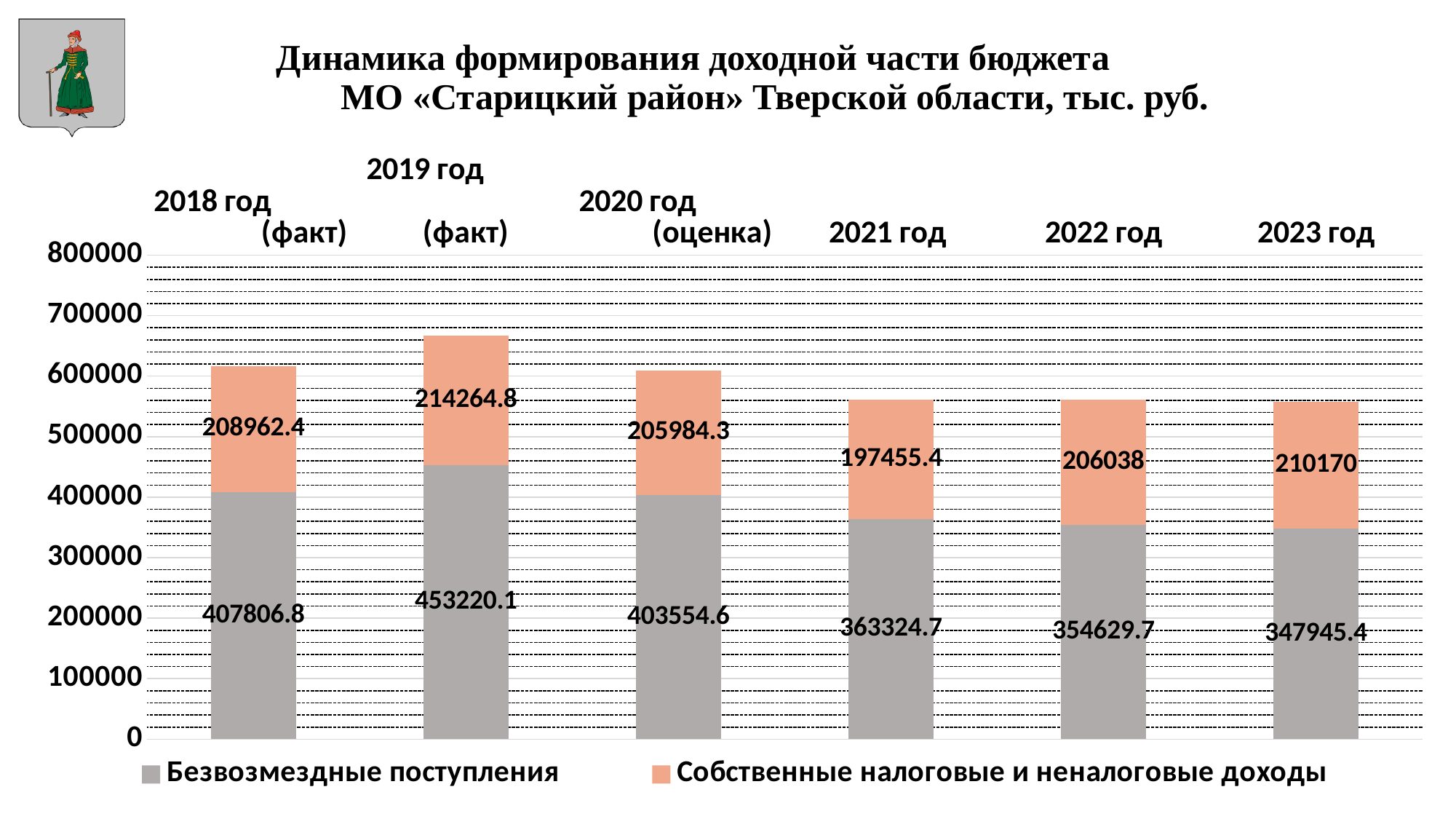
Is the total height of the bar for 2019 год (факт) greater or less than 600000? greater Which year has the highest value of Безвозмездные поступления? 2019 год (факт) How many year categories are plotted on the x axis? 6 Which year has the lowest value of Собственные налоговые и неналоговые доходы? 2021 год What is the difference between Безвозмездные поступления in 2019 год (факт) and in 2018 год (факт)? 45413.3 Which is larger: Собственные налоговые и неналоговые доходы in 2018 год (факт) or in 2022 год? 2018 год (факт) How many series does the legend list? 2 What type of chart is shown on the slide? Stacked bar chart What is the value of Собственные налоговые и неналоговые доходы for 2022 год? 206038 From 2019 год (факт) to 2023 год, do the values of Безвозмездные поступления rise or fall? fall What is the value of Безвозмездные поступления for 2019 год (факт)? 453220.1 What is the total of the stacked bar for 2021 год? 560780.1